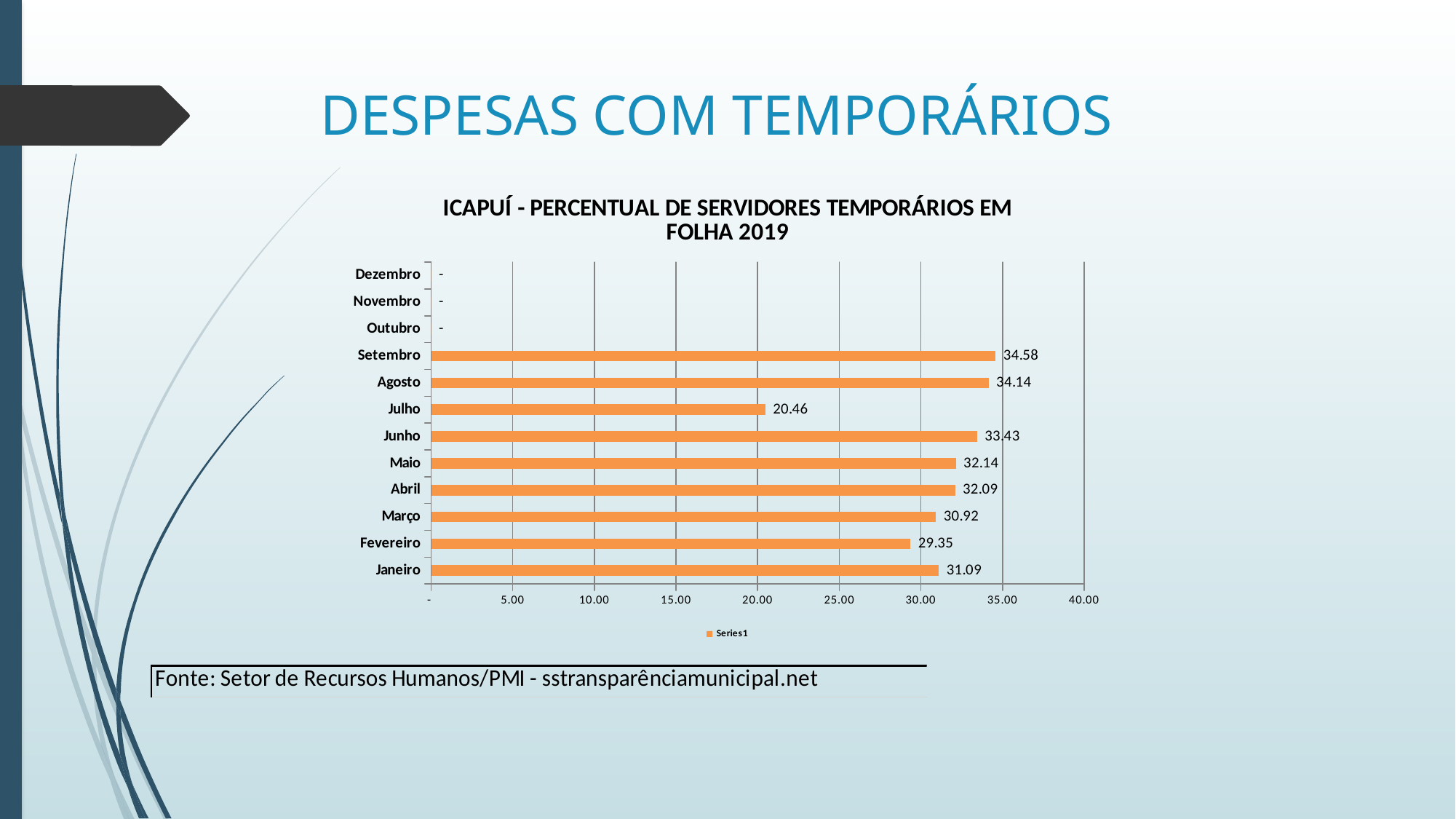
Among the months with a plotted bar, which has the lowest value? Julho What is the value for Setembro? 34.58 What is the title of the chart? ICAPUÍ - PERCENTUAL DE SERVIDORES TEMPORÁRIOS EM FOLHA 2019 What kind of chart is shown? bar chart Is the value for Julho greater or less than 25.00? less Which month has the highest value? Setembro What is the value for Janeiro? 31.09 What is the difference between the values for Janeiro and Fevereiro? 1.74 Which is larger, the value for Março or the value for Fevereiro? Março What is the difference between the values for Setembro and Agosto? 0.44 What is the value for Julho? 20.46 How many month categories are listed on the vertical axis? 12